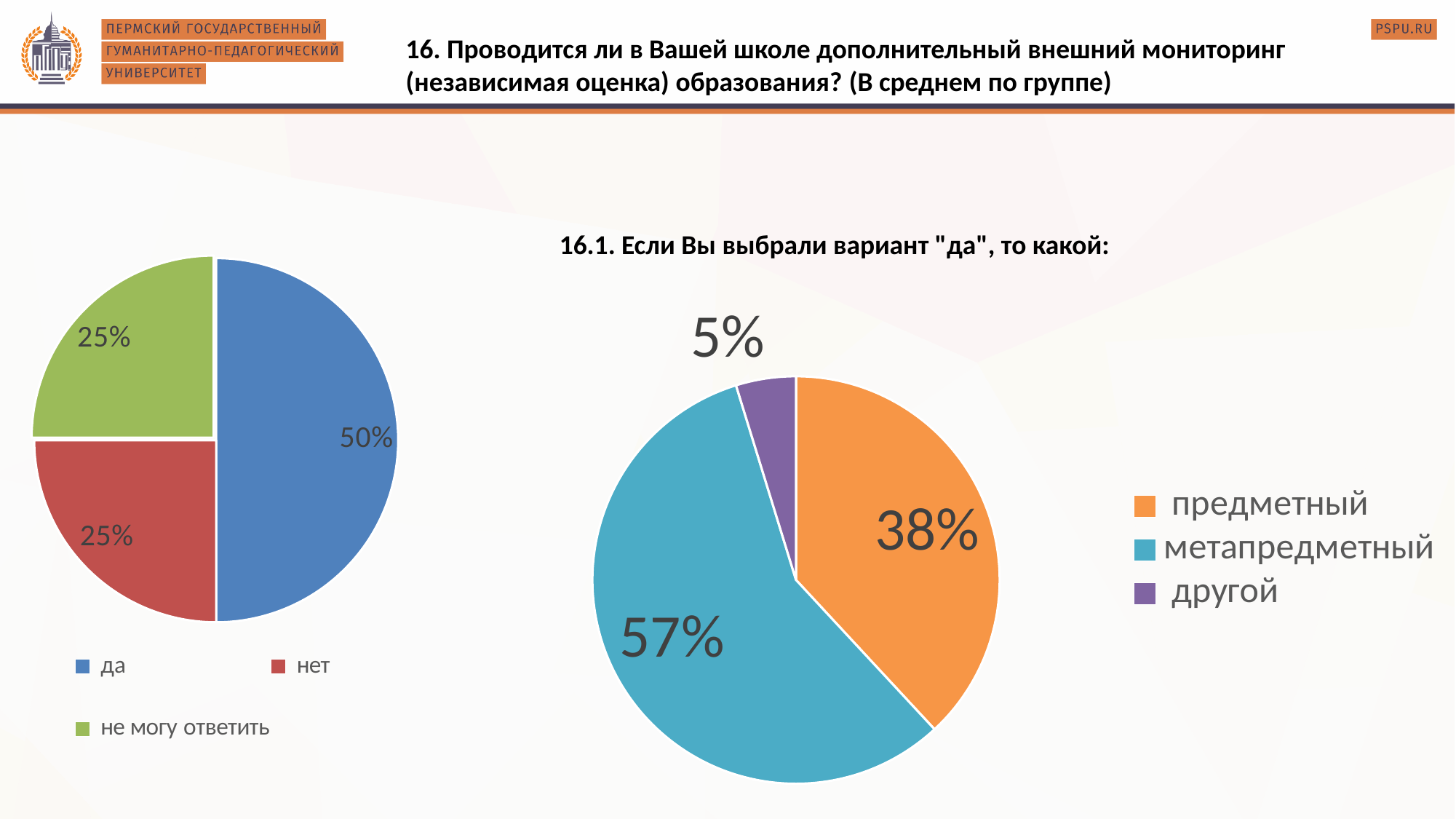
In the right pie chart (16.1), which is larger: "предметный" or "метапредметный"? метапредметный In the left pie chart, what share of respondents answered "не могу ответить"? 25% In the right pie chart (16.1), what share is "другой"? 5% In the left pie chart, what share of respondents answered "нет"? 25% In the left pie chart, what share of respondents answered "да"? 50% In the right pie chart (16.1), what share is "предметный"? 38% What type of chart is used on the left side of the slide? Pie chart In the left pie chart, which answer has the largest share? да In the right pie chart (16.1), what is the difference between the shares of "метапредметный" and "предметный"? 19% In the left pie chart, how many slices are there? 3 In the right pie chart (16.1), which category has the smallest share? другой In the right pie chart (16.1), what share is "метапредметный"? 57%